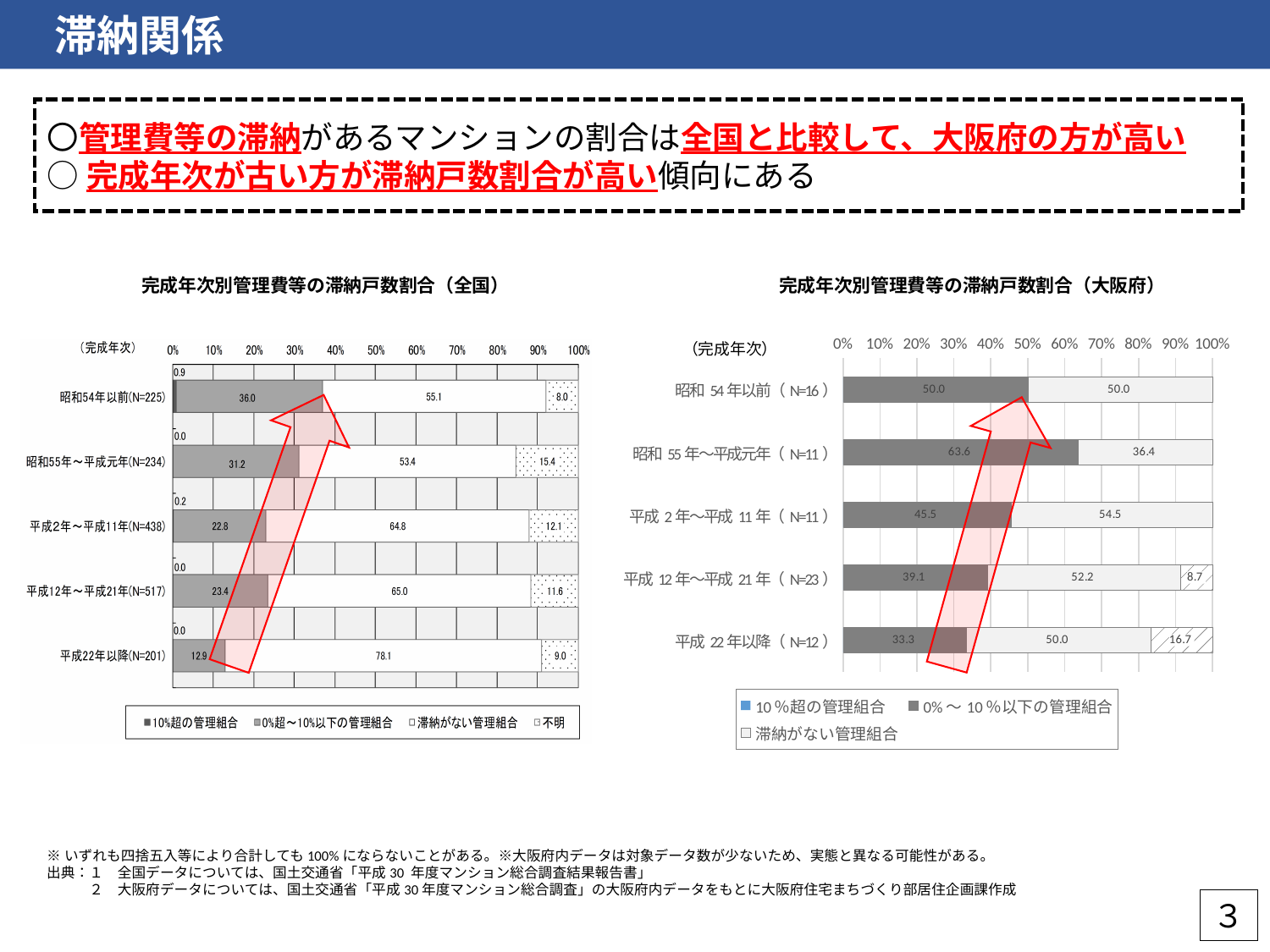
In the 全国 chart (left), what is the value for 滞納がない管理組合 in the 平成22年以降(N=201) category? 78.1 In the 全国 chart (left), what is the difference between the 不明 values for 昭和55年～平成元年(N=234) and 昭和54年以前(N=225)? 7.4 In the 大阪府 chart (right), what is the value for 滞納がない管理組合 in the 平成22年以降(N=12) category? 50.0 In the 全国 chart (left), how many series does the legend list? 4 In the 大阪府 chart (right), how many categories are shown? 5 In the 全国 chart (left), what is the value for 0%超～10%以下の管理組合 in the 昭和54年以前(N=225) category? 36.0 What kind of chart is the 大阪府 chart (right)? Stacked horizontal bar chart In the 全国 chart (left), which category has the highest value for 滞納がない管理組合? 平成22年以降(N=201) In the 全国 chart (left), which category has the lowest value for 0%超～10%以下の管理組合? 平成22年以降(N=201)